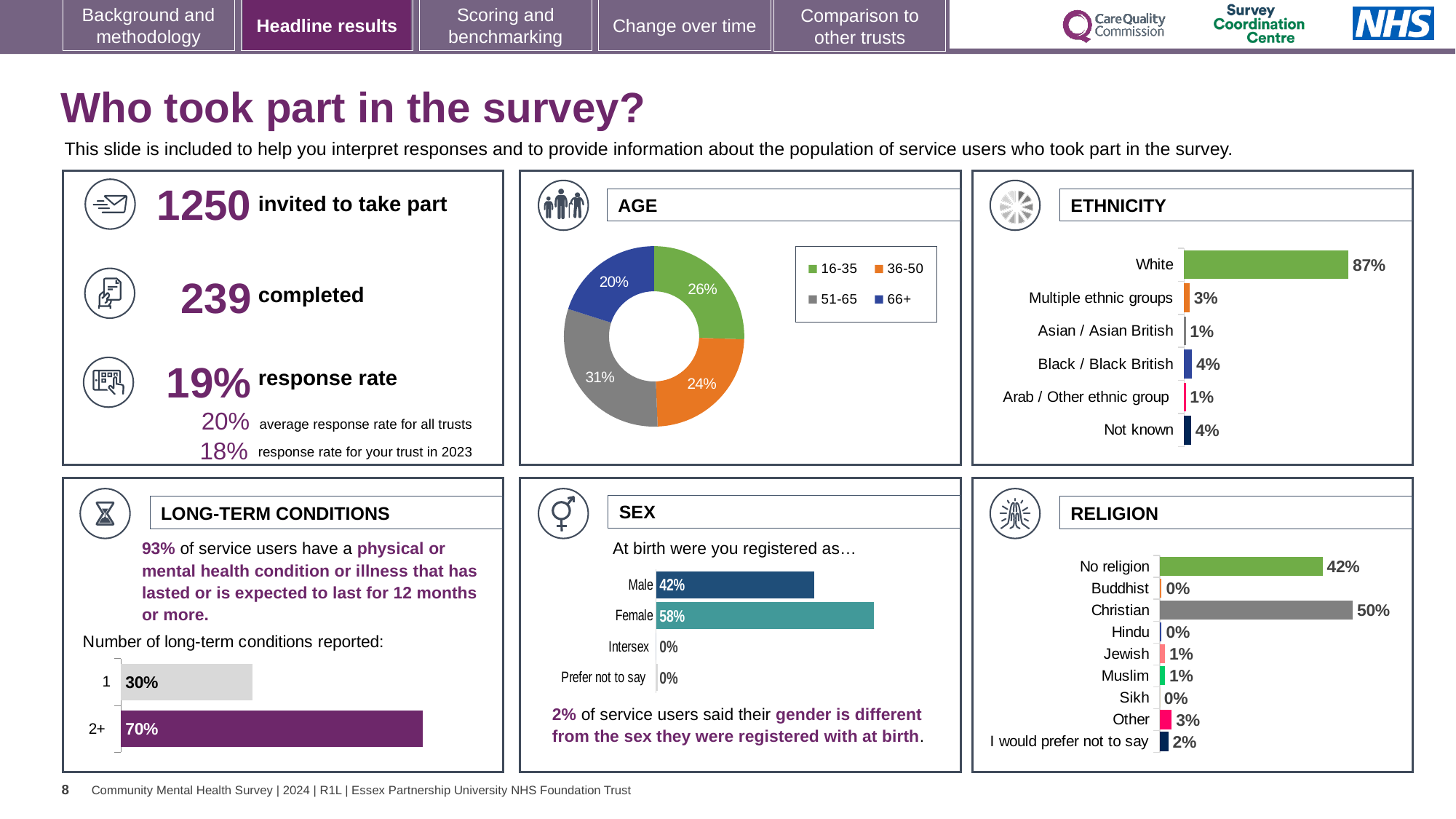
What kind of chart is the AGE chart? Doughnut chart In the ETHNICITY chart, what is the value for Multiple ethnic groups? 3% How many age groups does the legend of the AGE chart list? 4 In the AGE chart, what percentage of respondents are aged 51-65? 31% In the LONG-TERM CONDITIONS chart, what percentage reported 2+ conditions? 70% In the ETHNICITY chart, what is the difference between White and Black / Black British? 83% In the RELIGION chart, what is the difference between Christian and No religion? 8% How many categories are shown in the ETHNICITY chart? 6 In the RELIGION chart, which category has the highest value? Christian In the SEX chart, which is larger, Male or Female? Female In the ETHNICITY chart, which category has the highest value? White In the AGE chart, which age group has the smallest share? 66+